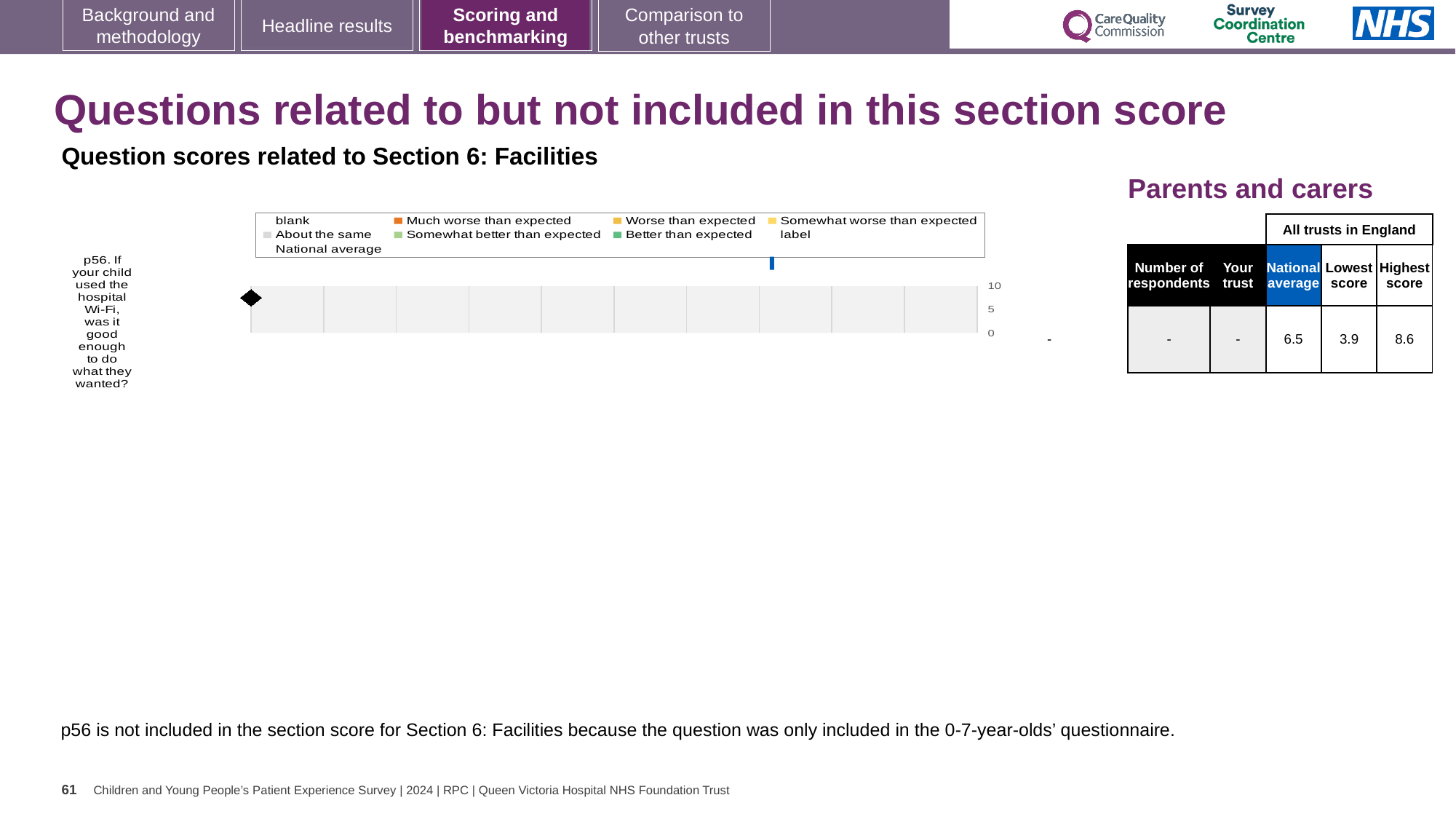
Which question is plotted on the chart? p56. If your child used the hospital Wi-Fi, was it good enough to do what they wanted? What is the highest tick value shown on the chart's value axis? 10 What kind of chart is used to show the p56 question score? bar chart How many questions (categories) are plotted on the chart? 1 What value is printed for the trust's score on the p56 chart? -